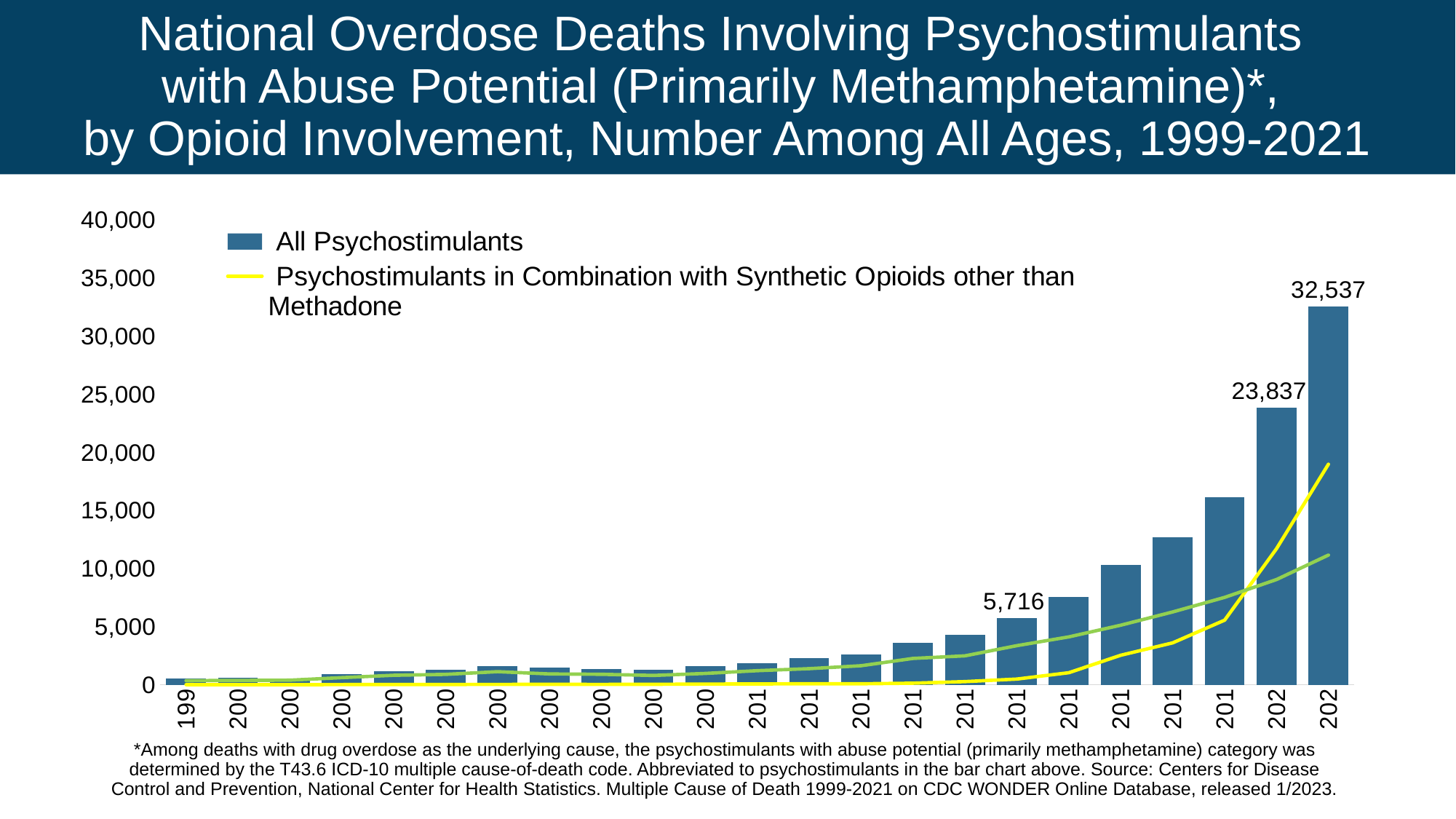
What is the difference between the All Psychostimulants values for 2020 and 2015? 18,121 Which year has the highest All Psychostimulants bar? 2021 Do the All Psychostimulants values generally rise or fall from 1999 to 2021? rise How many series does the legend list? 2 What is the value of the All Psychostimulants bar labeled in 2015? 5,716 Is the All Psychostimulants value for 2019 greater or less than 15,000? greater What is the value of the All Psychostimulants bar for 2021, the last year shown? 32,537 What is the difference between the All Psychostimulants values for 2021 and 2020? 8,700 What colour is the line for Psychostimulants in Combination with Synthetic Opioids other than Methadone? yellow What is the value of the All Psychostimulants bar for 2020? 23,837 How many years (bars) are plotted on the chart? 23 What kind of chart is shown on the slide? combination bar and line chart